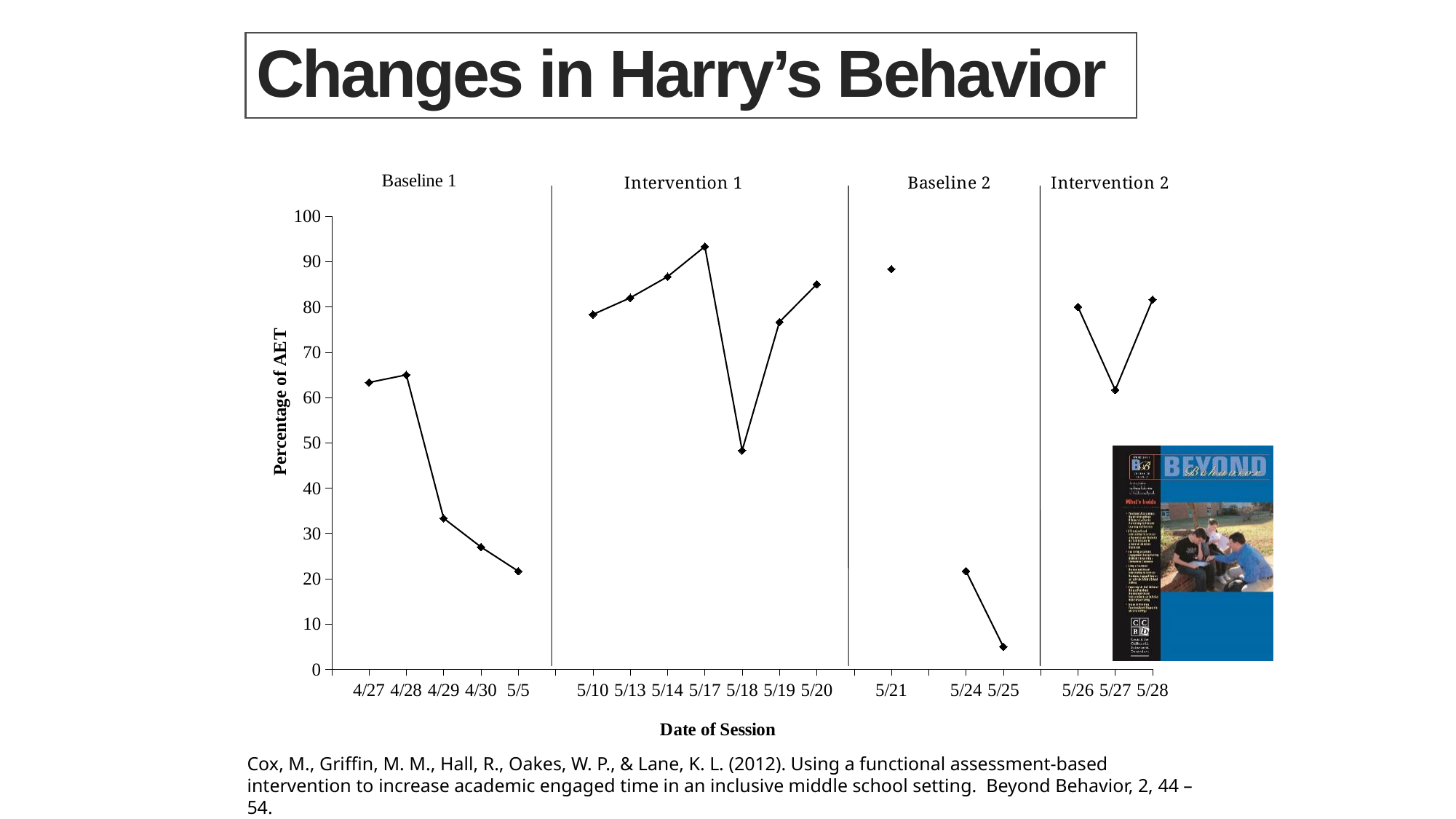
Which date has a higher percentage of AET, 5/17 or 5/18? 5/17 How many dates of session are shown on the x axis? 18 Which date has a higher percentage of AET, 4/28 or 4/29? 4/28 What kind of chart is shown on the slide? line chart Is the percentage of AET on 5/25 greater or less than 10? less Is the percentage of AET on 5/18 greater or less than 60? less What is the label of the y axis? Percentage of AET On which date of session is the percentage of AET lowest? 5/25 Is the percentage of AET on 5/21 greater or less than 80? greater During the Baseline 1 phase, does the percentage of AET rise or fall from 4/27 to 5/5? fall On which date of session is the percentage of AET highest? 5/17